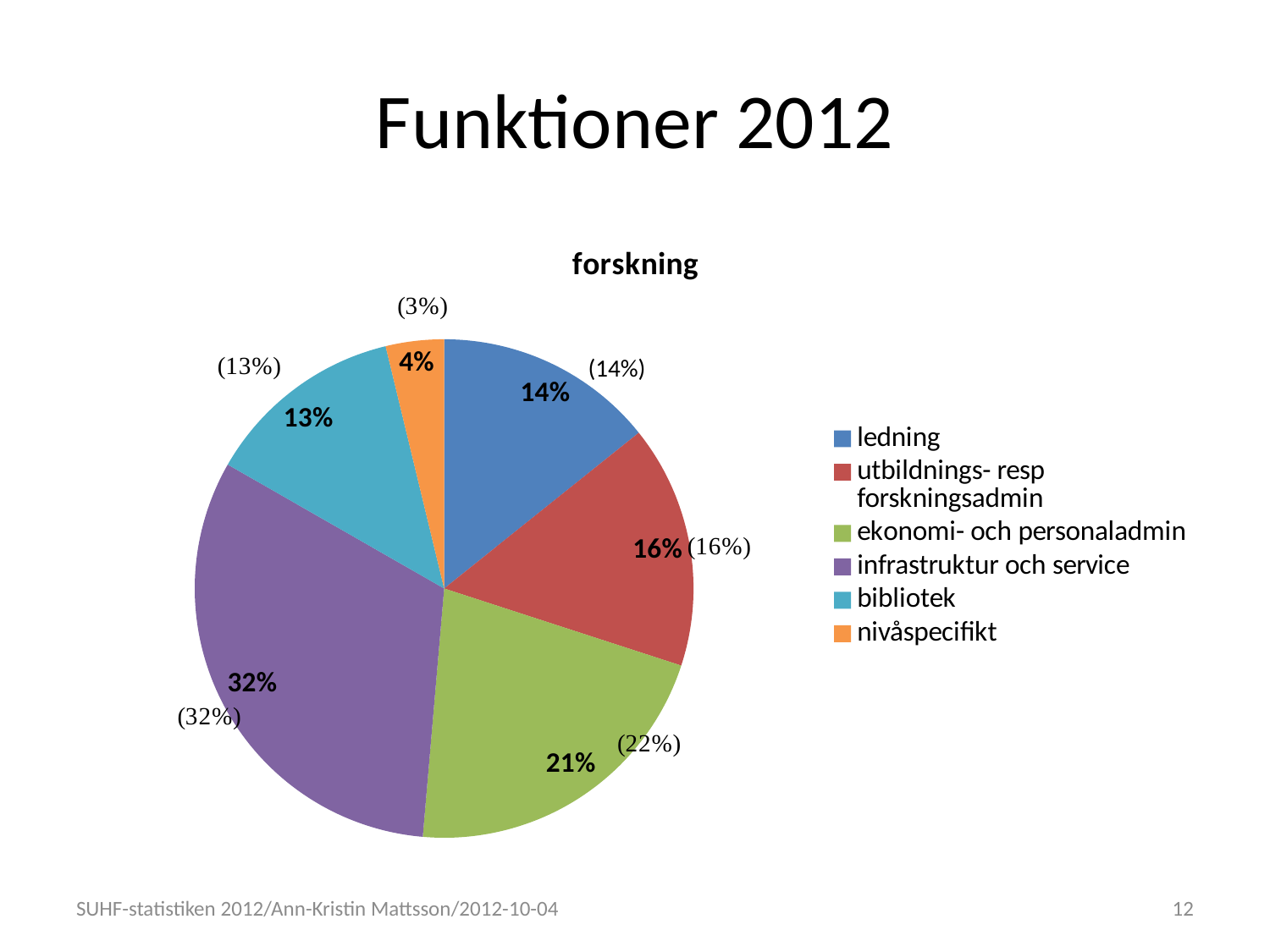
What is the data label for 'ledning'? 14% Which category has the largest slice of the pie? infrastruktur och service What is the data label for 'bibliotek'? 13% What is the difference in percentage points between 'infrastruktur och service' and 'ekonomi- och personaladmin'? 11 Which is larger, the slice for 'utbildnings- resp forskningsadmin' or the slice for 'nivåspecifikt'? utbildnings- resp forskningsadmin How many entries does the legend list? 6 What is the data label for 'ekonomi- och personaladmin'? 21% What is the title of the chart? forskning Which category has the smallest slice of the pie? nivåspecifikt What share of the pie does 'infrastruktur och service' have? 32% How many slices does the pie chart have? 6 What type of chart is shown on the slide? pie chart